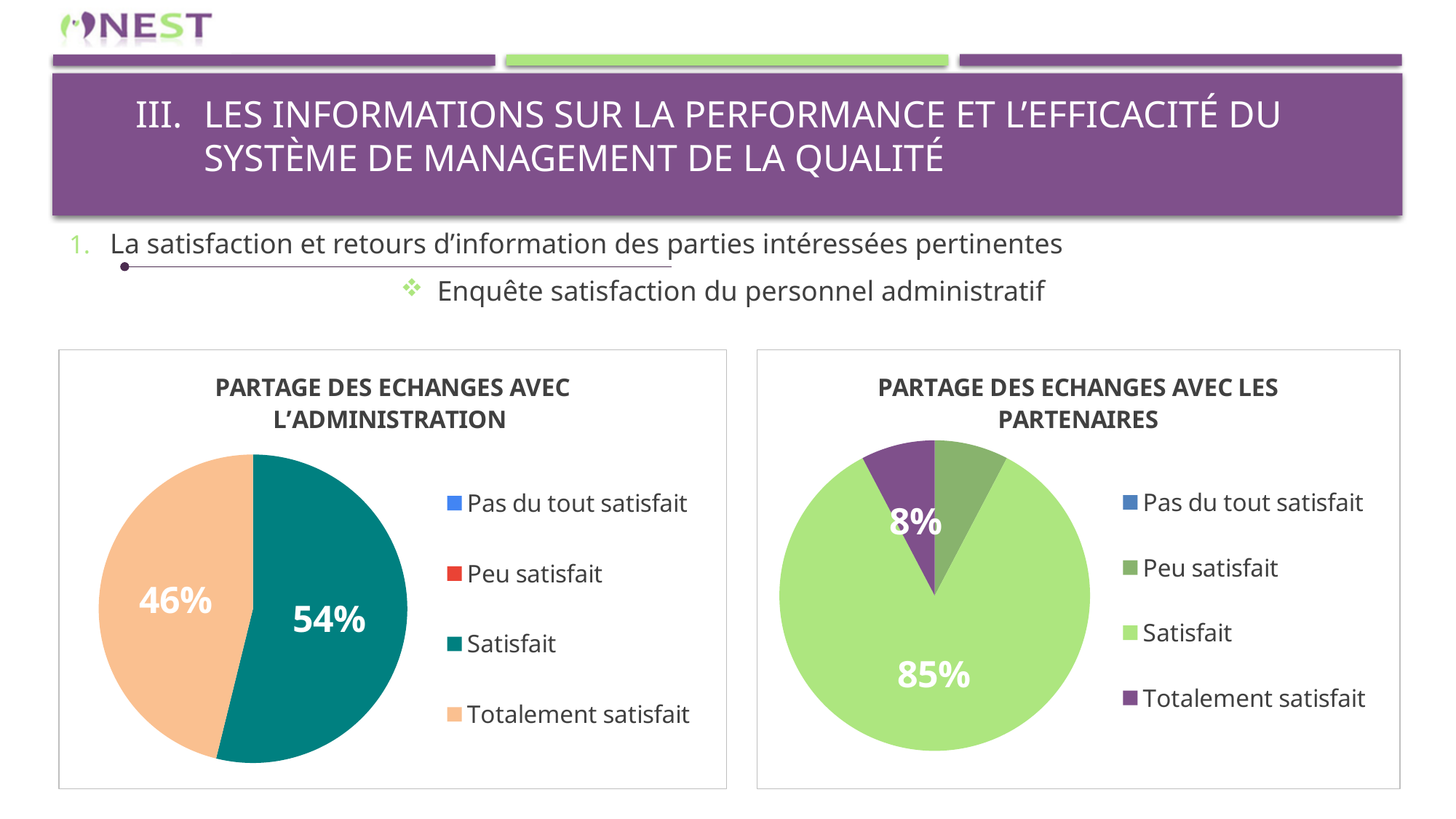
How many entries does the legend of the chart titled "PARTAGE DES ECHANGES AVEC LES PARTENAIRES" list? 4 In the chart titled "PARTAGE DES ECHANGES AVEC LES PARTENAIRES", which is larger, Satisfait or Totalement satisfait? Satisfait In the chart titled "PARTAGE DES ECHANGES AVEC L'ADMINISTRATION", which category has the largest slice? Satisfait In the chart titled "PARTAGE DES ECHANGES AVEC L'ADMINISTRATION", what share is labelled for Satisfait? 54% In the chart titled "PARTAGE DES ECHANGES AVEC LES PARTENAIRES", what is the difference in percentage points between Satisfait and Totalement satisfait? 77 In the chart titled "PARTAGE DES ECHANGES AVEC LES PARTENAIRES", what share is labelled for Satisfait? 85% In the chart titled "PARTAGE DES ECHANGES AVEC LES PARTENAIRES", which category has the largest slice? Satisfait In the chart titled "PARTAGE DES ECHANGES AVEC L'ADMINISTRATION", what share is labelled for Totalement satisfait? 46% What type of chart is the chart on the left of the slide? Pie chart In the chart titled "PARTAGE DES ECHANGES AVEC LES PARTENAIRES", what share is labelled for Totalement satisfait? 8% What is the title of the chart on the right of the slide? PARTAGE DES ECHANGES AVEC LES PARTENAIRES In the chart titled "PARTAGE DES ECHANGES AVEC L'ADMINISTRATION", what is the difference in percentage points between Satisfait and Totalement satisfait? 8